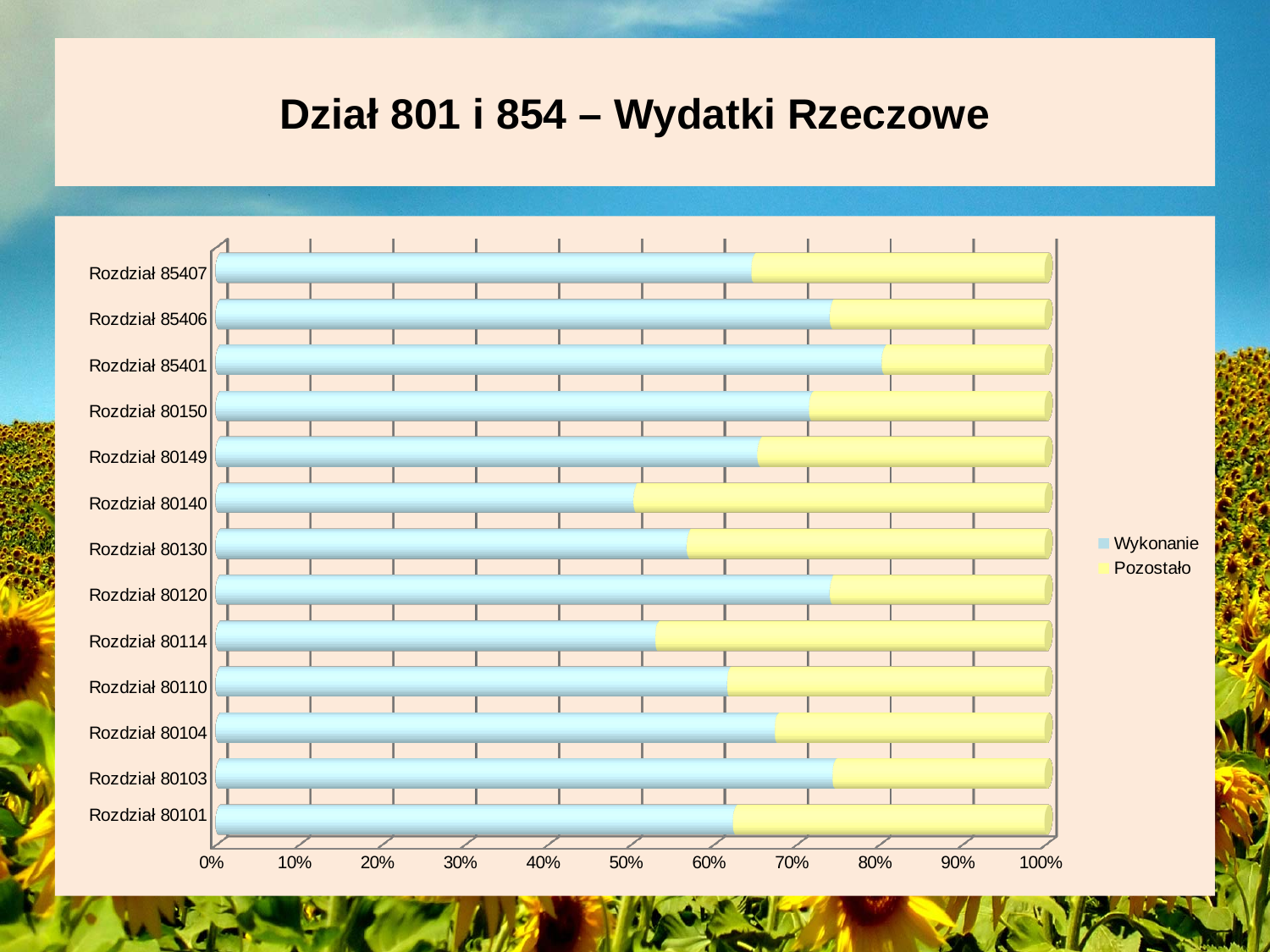
Which has the larger Pozostało share, Rozdział 80140 or Rozdział 85401? Rozdział 80140 What is the title of the chart? Dział 801 i 854 – Wydatki Rzeczowe How many categories (Rozdział entries) are plotted on the chart? 13 Which has the larger Wykonanie share, Rozdział 85401 or Rozdział 80140? Rozdział 85401 Is the Wykonanie value for Rozdział 80140 greater or less than 60%? less Which series is shown in light blue according to the legend? Wykonanie What kind of chart is shown on the slide? bar chart Is the Wykonanie value for Rozdział 85401 greater or less than 70%? greater How many series does the legend list? 2 Which category has the highest Wykonanie share? Rozdział 85401 Is the Wykonanie value for Rozdział 85406 greater or less than 70%? greater